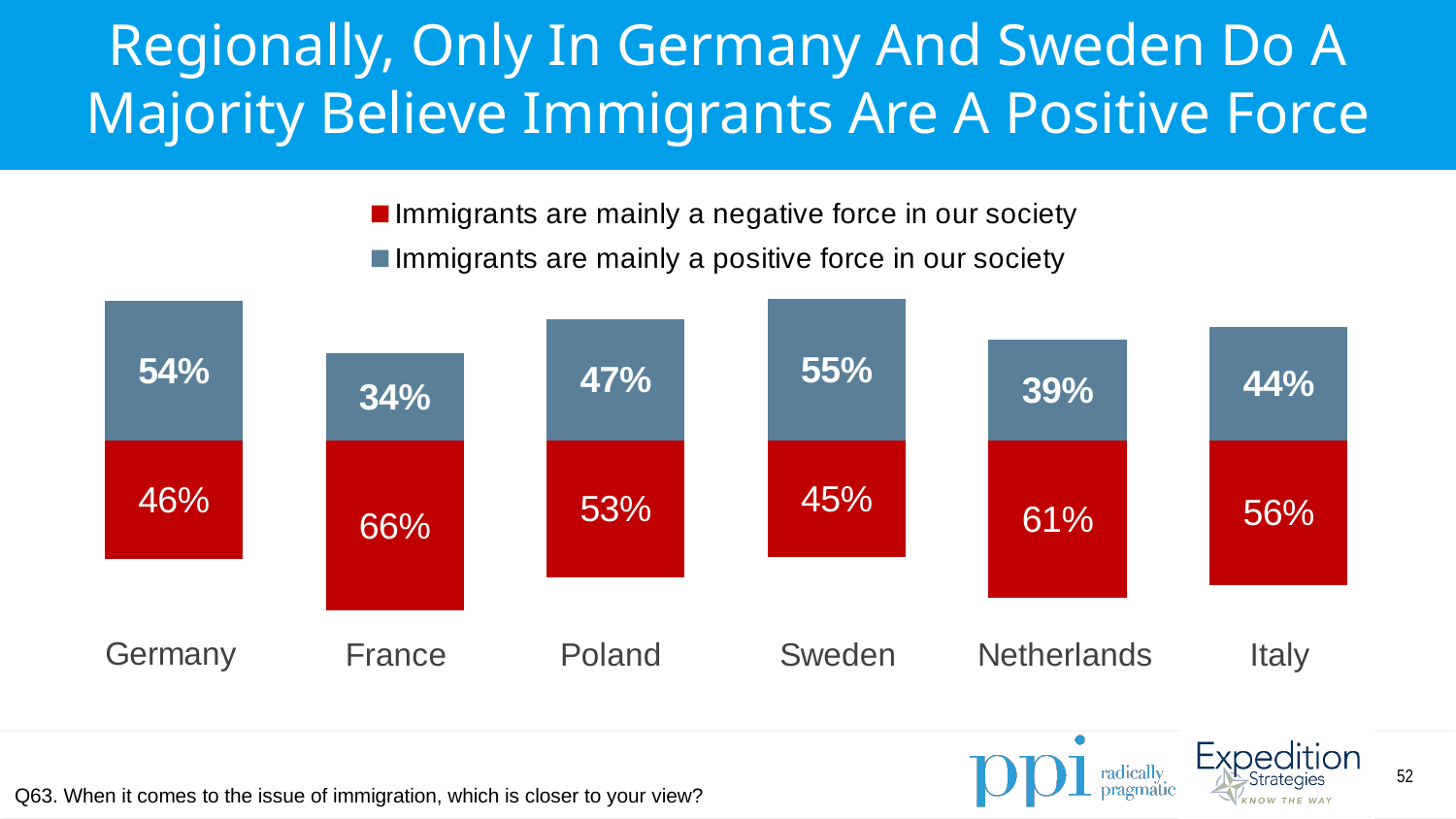
What percentage of respondents in Germany say immigrants are mainly a positive force in our society? 54% What is the total of the two segments in the Sweden bar? 100% Which colour represents 'Immigrants are mainly a negative force in our society' in the legend? Red What percentage of respondents in France say immigrants are mainly a negative force in our society? 66% Which is larger in Poland: the share saying immigrants are a negative force or the share saying they are a positive force? Negative force (53%) Which country has the highest share saying immigrants are mainly a positive force? Sweden How many series does the legend list? 2 What percentage of respondents in the Netherlands say immigrants are mainly a positive force in our society? 39% What is the difference between the share saying immigrants are a negative force in Italy and the share saying they are a positive force in Italy? 12 percentage points What type of chart is shown on the slide? Stacked bar chart How many countries are shown in the chart? 6 Which country has the lowest share saying immigrants are mainly a positive force? France